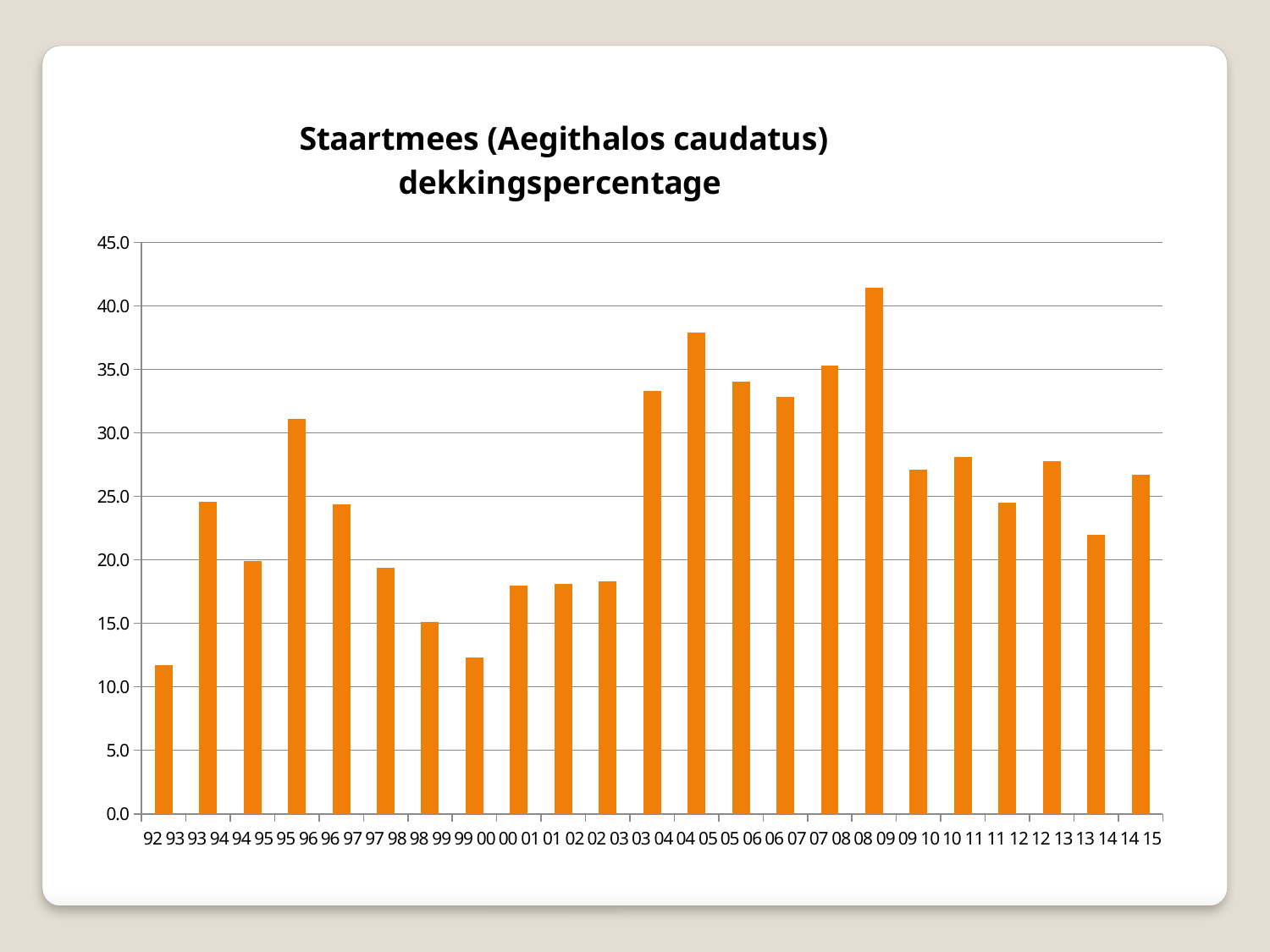
Is the value for 92 93 greater or less than 15.0? less What kind of chart is shown on the slide? bar chart Which season has the highest bar? 08 09 Which season has the lowest bar? 92 93 Is the value for 08 09 greater or less than 40.0? greater Do the values rise or fall from 97 98 to 99 00? fall What colour are the bars in the chart? orange What is the title of the chart? Staartmees (Aegithalos caudatus) dekkingspercentage Is the value for 13 14 greater or less than 25.0? less Which is larger, the value for 03 04 or the value for 04 05? 04 05 How many bars (seasons) are plotted in the chart? 23